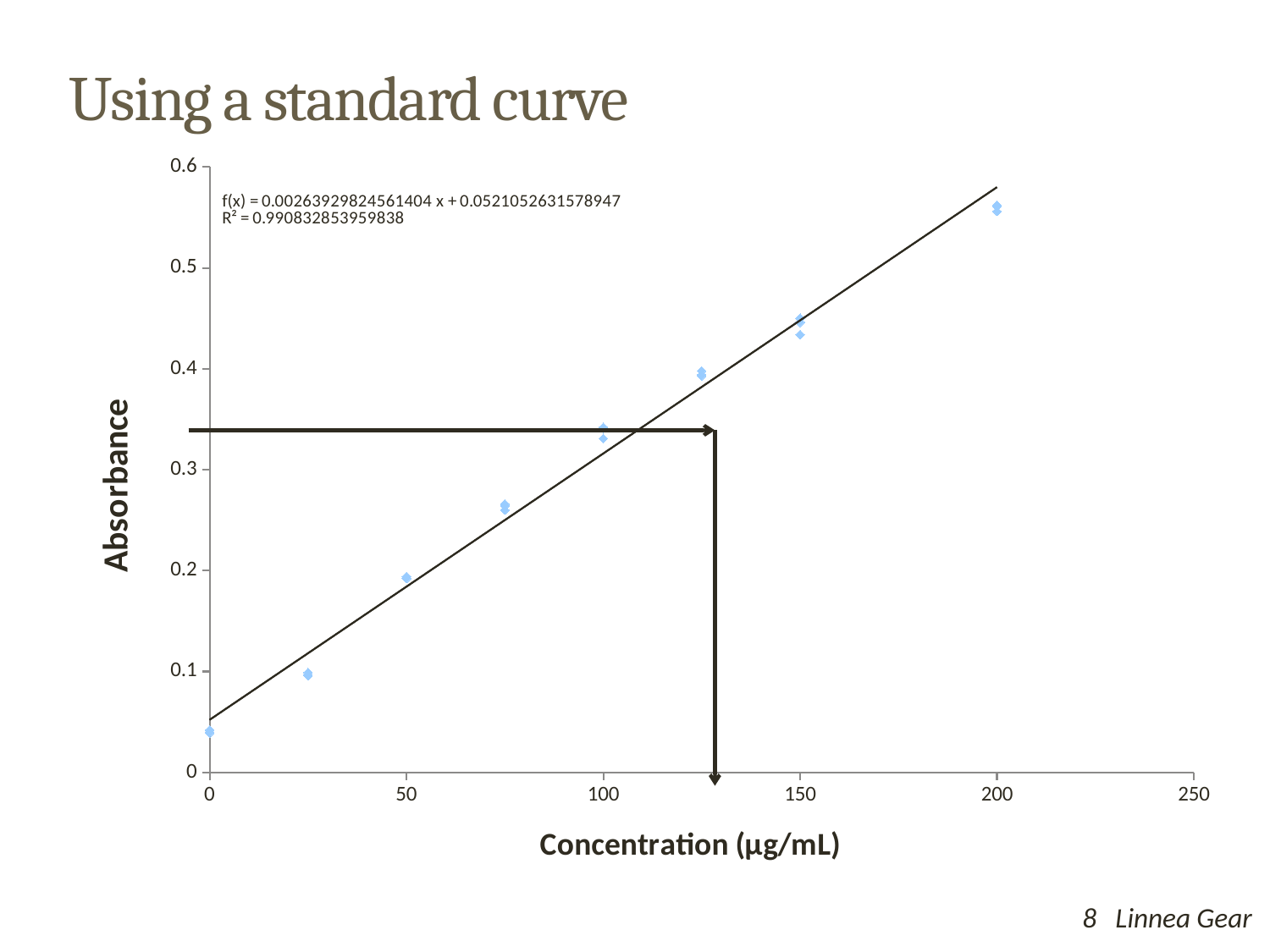
Is the absorbance at a concentration of 150 greater or less than 0.4? greater What kind of chart is shown on the slide? scatter plot Is the absorbance at a concentration of 200 greater or less than 0.5? greater At which concentration is the absorbance highest? 200 How many distinct concentration levels have data points plotted? 8 At which concentration is the absorbance lowest? 0 What is the title of the y axis? Absorbance Which has the higher absorbance: a concentration of 150 or a concentration of 100? 150 Do the absorbance values rise or fall as concentration increases along the x axis? rise What is the title of the x axis? Concentration (µg/mL) Is the absorbance at a concentration of 125 greater or less than 0.5? less